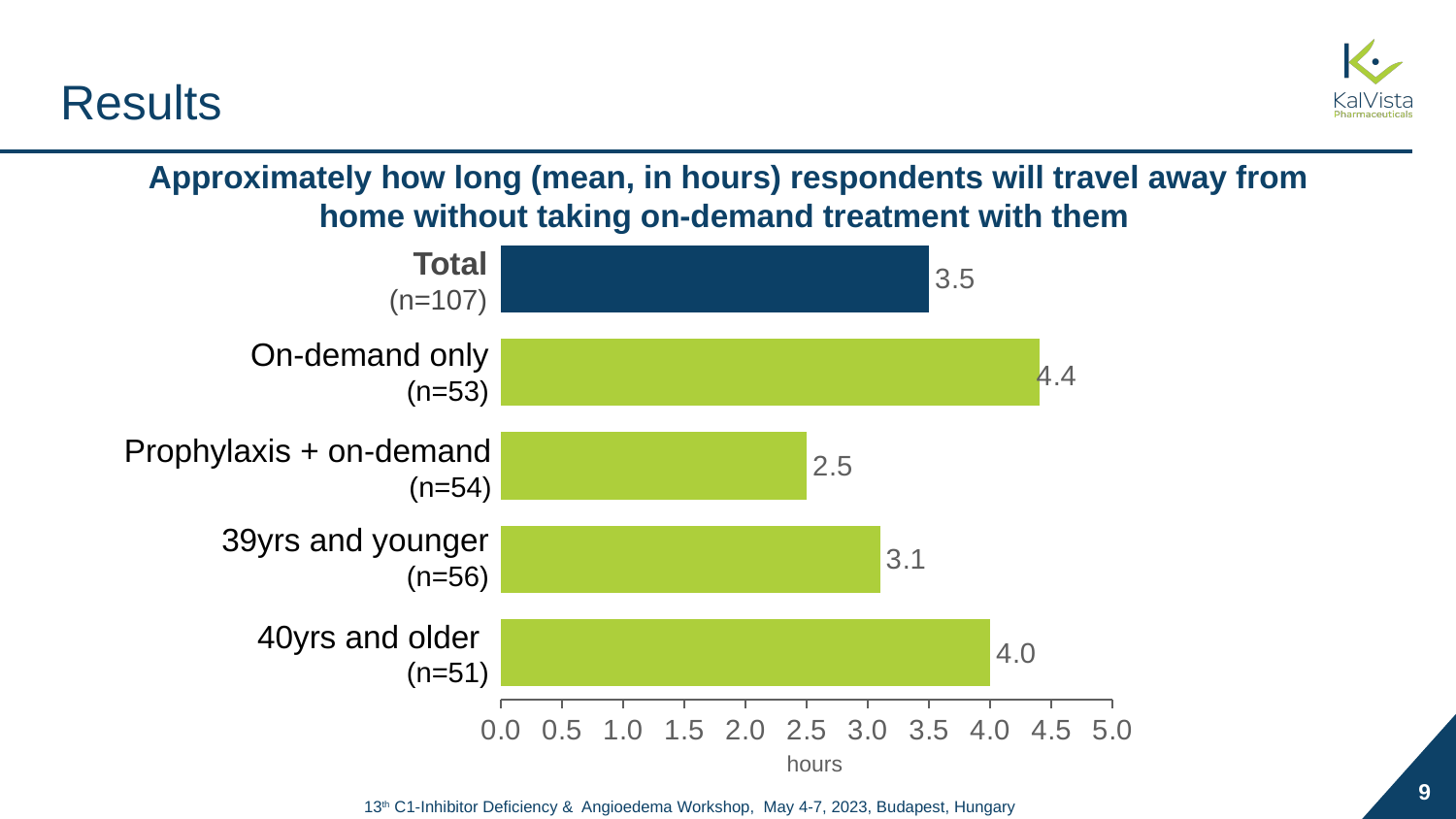
What is the value for the Prophylaxis + on-demand (n=54) group? 2.5 What is the mean number of hours for the Total (n=107) group? 3.5 What is the value for the On-demand only (n=53) group? 4.4 Which group has the highest mean hours? On-demand only Which group has the lowest mean hours? Prophylaxis + on-demand What type of chart is shown on the slide? Bar chart What is the value for the 40yrs and older (n=51) group? 4.0 What is the label of the x axis? hours How many groups are shown in the chart? 5 Is the value for 39yrs and younger greater or less than 3.5? less What is the difference in hours between the On-demand only group and the Prophylaxis + on-demand group? 1.9 Which group has a larger value: 39yrs and younger or 40yrs and older? 40yrs and older